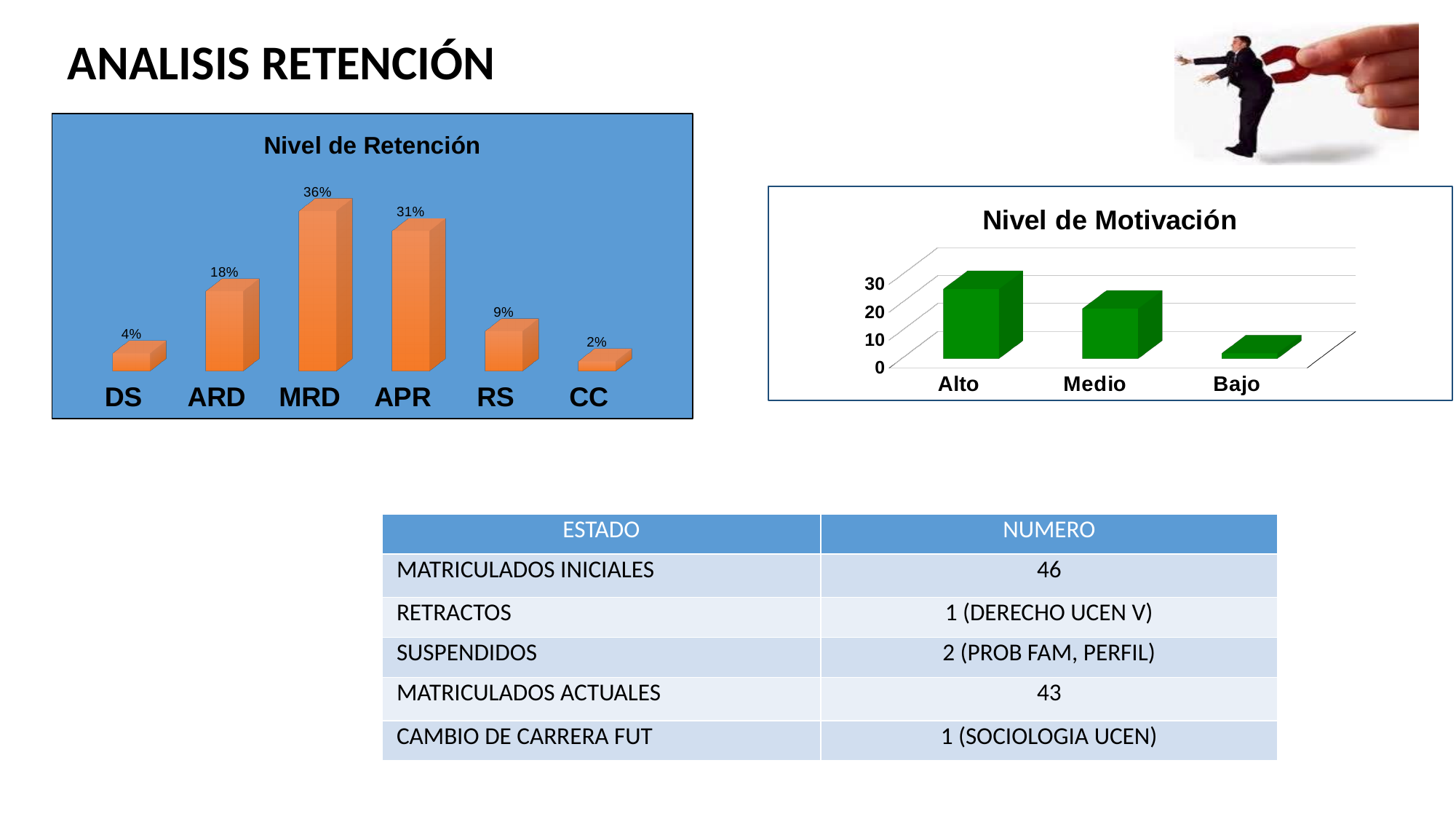
What kind of chart is the Nivel de Motivación chart? Bar chart In the Nivel de Retención chart, what is the difference between the values for MRD and APR? 5% In the Nivel de Retención chart, which is larger, the value for ARD or the value for RS? ARD In the Nivel de Retención chart, which category has the highest value? MRD In the Nivel de Retención chart, which category has the lowest value? CC In the Nivel de Motivación chart, is the value for Alto greater or less than 20? greater In the Nivel de Retención chart, what is the value for MRD? 36% How many categories are shown in the Nivel de Retención chart? 6 In the Nivel de Motivación chart, which category has the highest value? Alto In the Nivel de Motivación chart, is the value for Bajo greater or less than 10? less In the Nivel de Retención chart, what is the value for DS? 4% In the Nivel de Retención chart, what is the value for RS? 9%